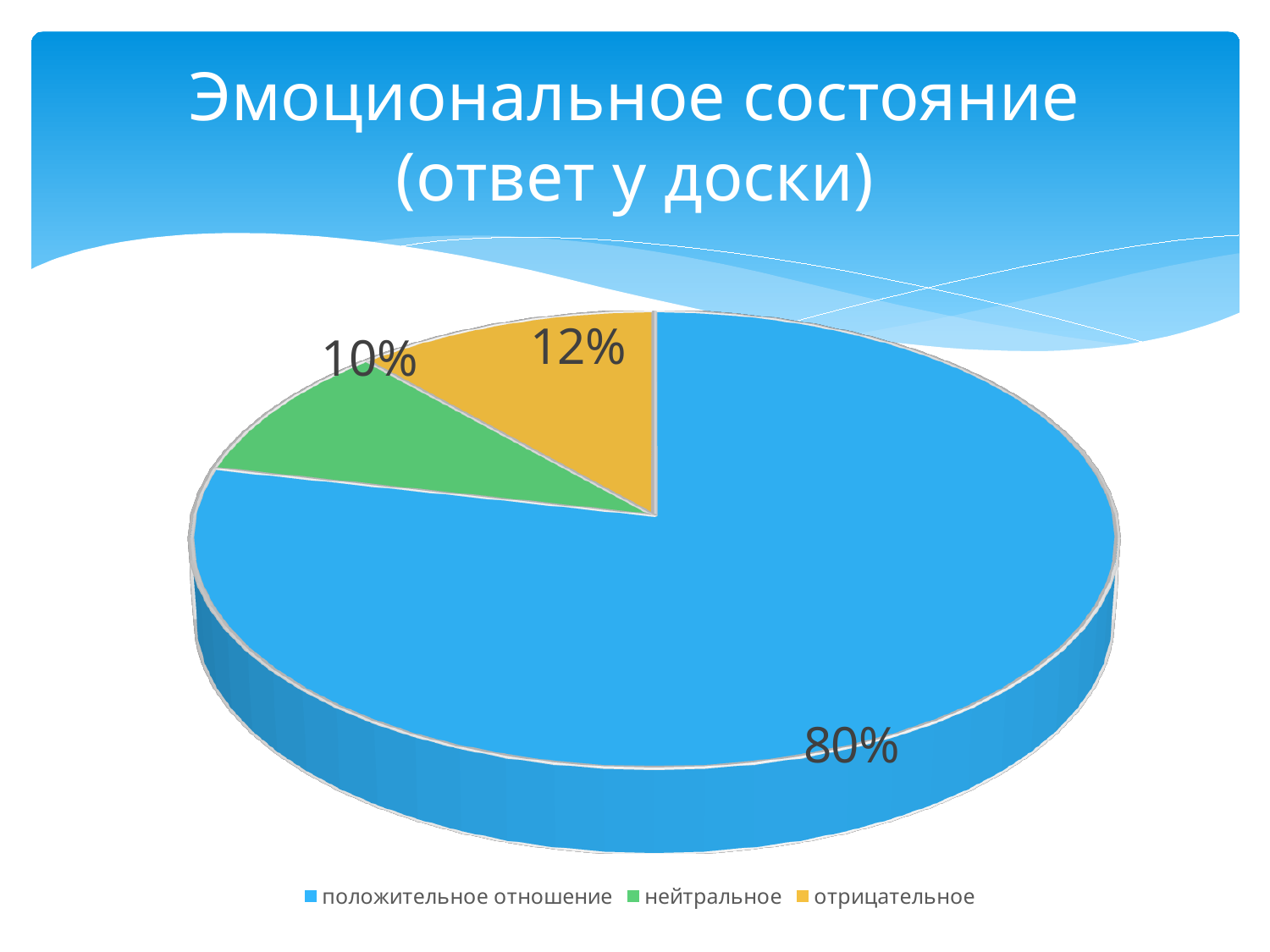
Which category has the largest slice of the pie? положительное отношение Which is larger, the value for "положительное отношение" or the value for "нейтральное"? положительное отношение What kind of chart is shown on the slide? Pie chart What is the difference between the values for "положительное отношение" and "отрицательное"? 68% What is the title of the chart on the slide? Эмоциональное состояние (ответ у доски) What colour is the slice for "отрицательное"? Yellow What is the value shown for "отрицательное"? 12% What is the value shown for "положительное отношение"? 80% Which category has the smallest slice of the pie? нейтральное How many categories does the pie chart have? 3 What is the difference between the values for "отрицательное" and "нейтральное"? 2% What is the value shown for "нейтральное"? 10%